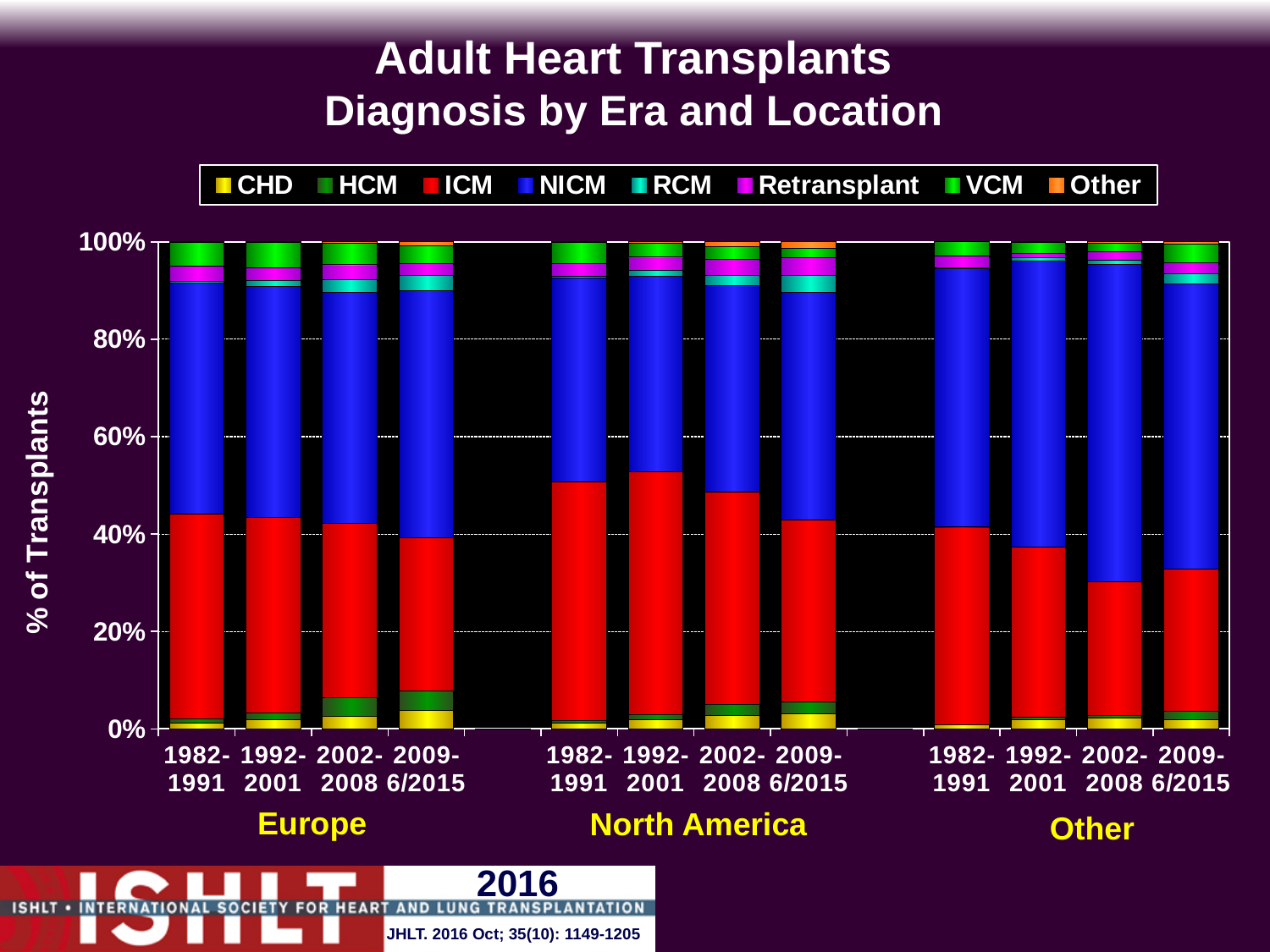
What kind of chart is shown on the slide? Stacked bar chart Is the ICM share for North America in 1982-1991 greater or less than 40%? greater What is the label on the y axis? % of Transplants Is the ICM share for Europe in 1982-1991 greater or less than 60%? less Is the ICM share for Other in 2002-2008 greater or less than 40%? less In the 1982-1991 era, which location group has the largest ICM share? North America What is the title of the chart? Adult Heart Transplants Diagnosis by Era and Location How many series does the legend list? 8 How many era categories are shown for each location group? 4 How many stacked bars are plotted in total across the three location groups? 12 Across the Europe bars, does the ICM share rise or fall from 1982-1991 to 2009-6/2015? Falls Which is larger, the ICM share for North America in 1982-1991 or the ICM share for Other in 2002-2008? North America in 1982-1991